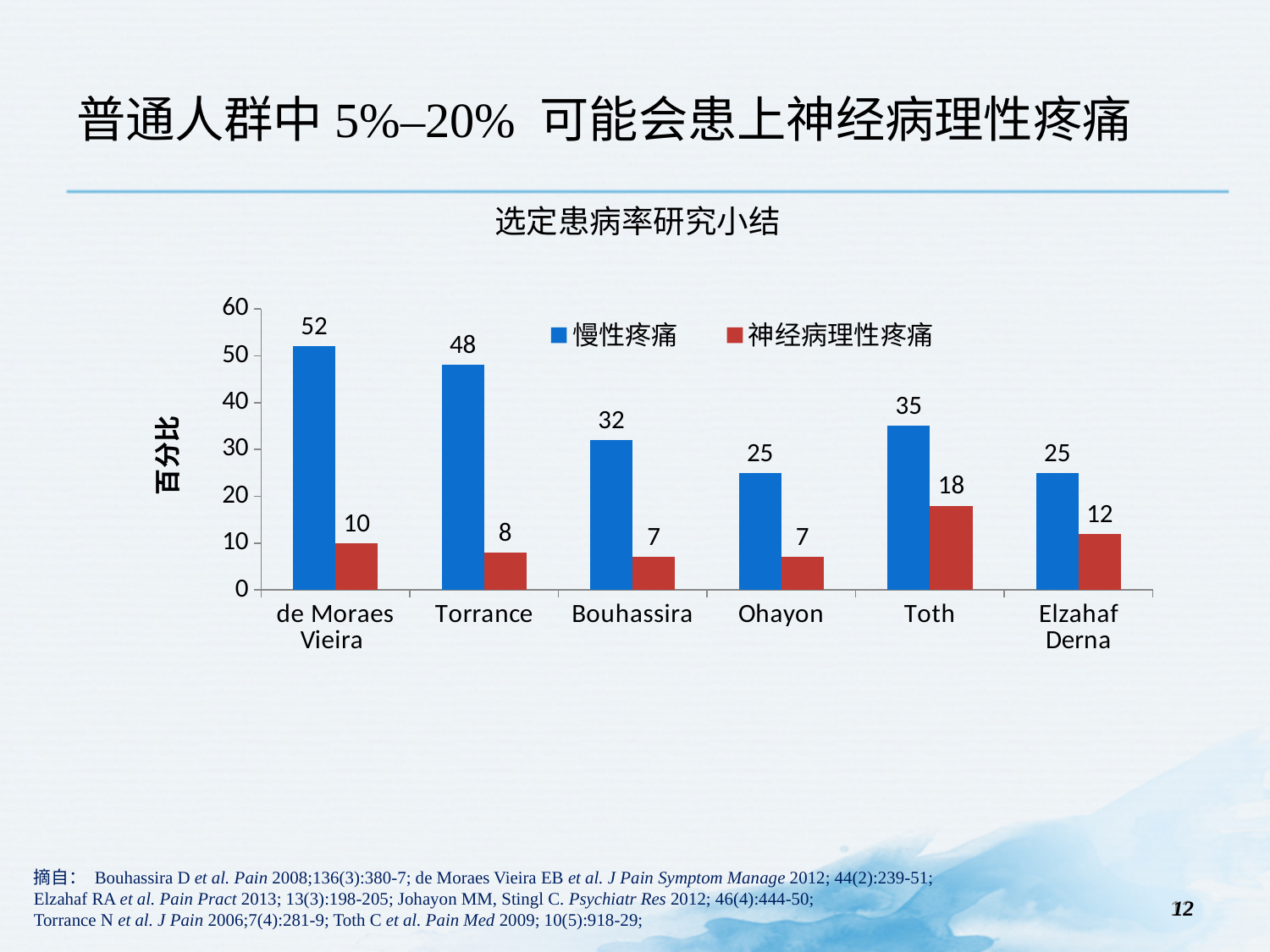
What is the difference between the 慢性疼痛 and 神经病理性疼痛 values for Torrance? 40 What is the value for 神经病理性疼痛 for Toth? 18 Which is larger: the 神经病理性疼痛 value for Elzahaf Derna or for de Moraes Vieira? Elzahaf Derna How many studies are shown on the x axis? 6 Which study has the highest value for 慢性疼痛? de Moraes Vieira What is the value for 慢性疼痛 for de Moraes Vieira? 52 What kind of chart is shown on the slide? Bar chart What is the value for 慢性疼痛 for Bouhassira? 32 What is the label on the y axis? 百分比 What is the title of the chart? 选定患病率研究小结 How many series does the legend list? 2 Which study has the highest value for 神经病理性疼痛? Toth